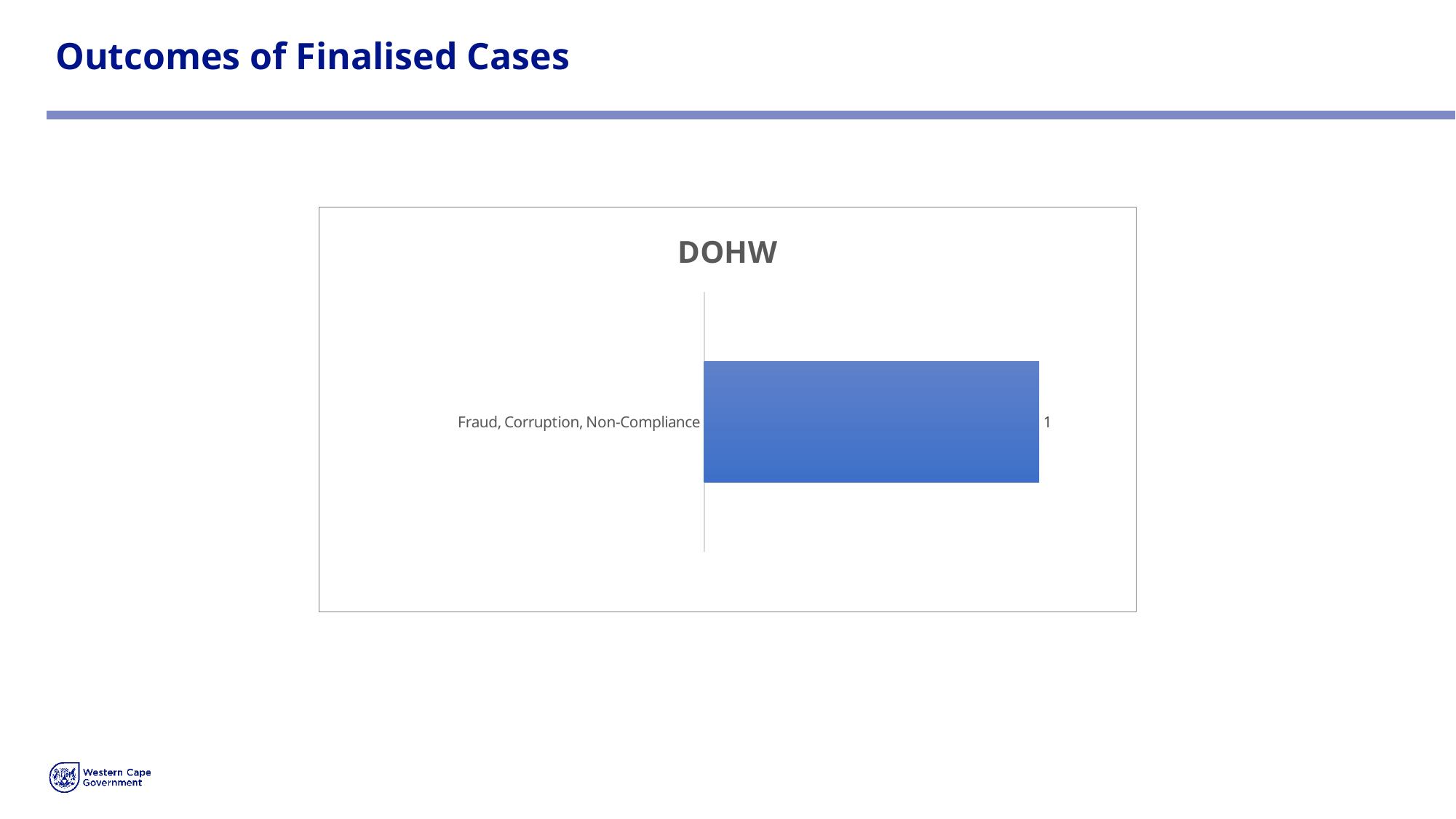
What is the title of the chart on the slide? DOHW What is the value for Fraud, Corruption, Non-Compliance in the DOHW chart? 1 Which category has the highest value in the DOHW chart? Fraud, Corruption, Non-Compliance How many categories are shown in the DOHW chart? 1 What is the label of the only category in the DOHW chart? Fraud, Corruption, Non-Compliance What kind of chart is the DOHW chart? bar chart